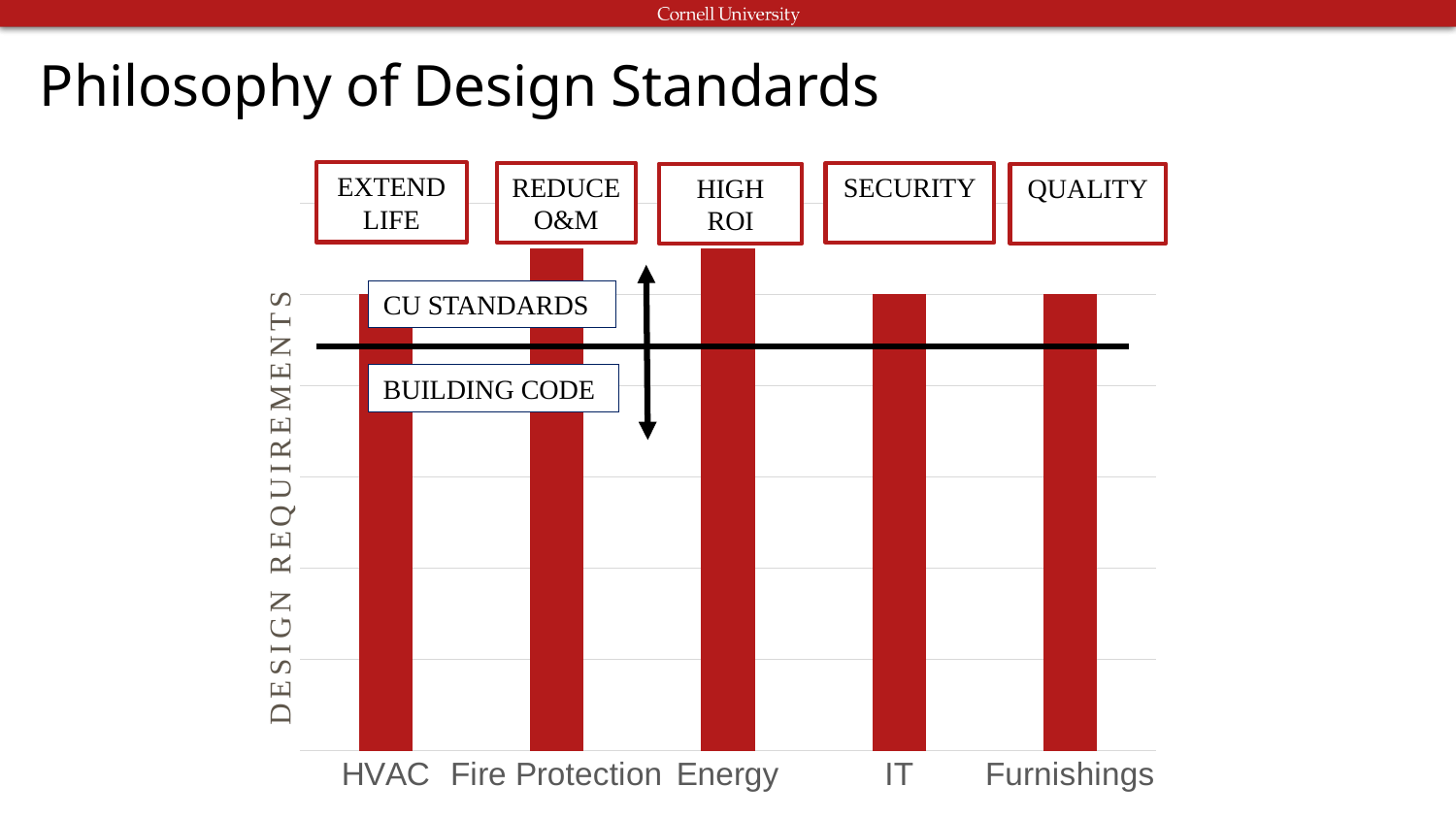
Which bar is taller, Energy or Furnishings? Energy How many categories are plotted along the x axis of the chart? 5 Which bar is taller, Energy or IT? Energy Which bar is taller, Fire Protection or HVAC? Fire Protection What kind of chart is shown on the slide? Bar chart What label is shown in the box above the Energy bar? HIGH ROI What is the label on the vertical axis of the chart? DESIGN REQUIREMENTS